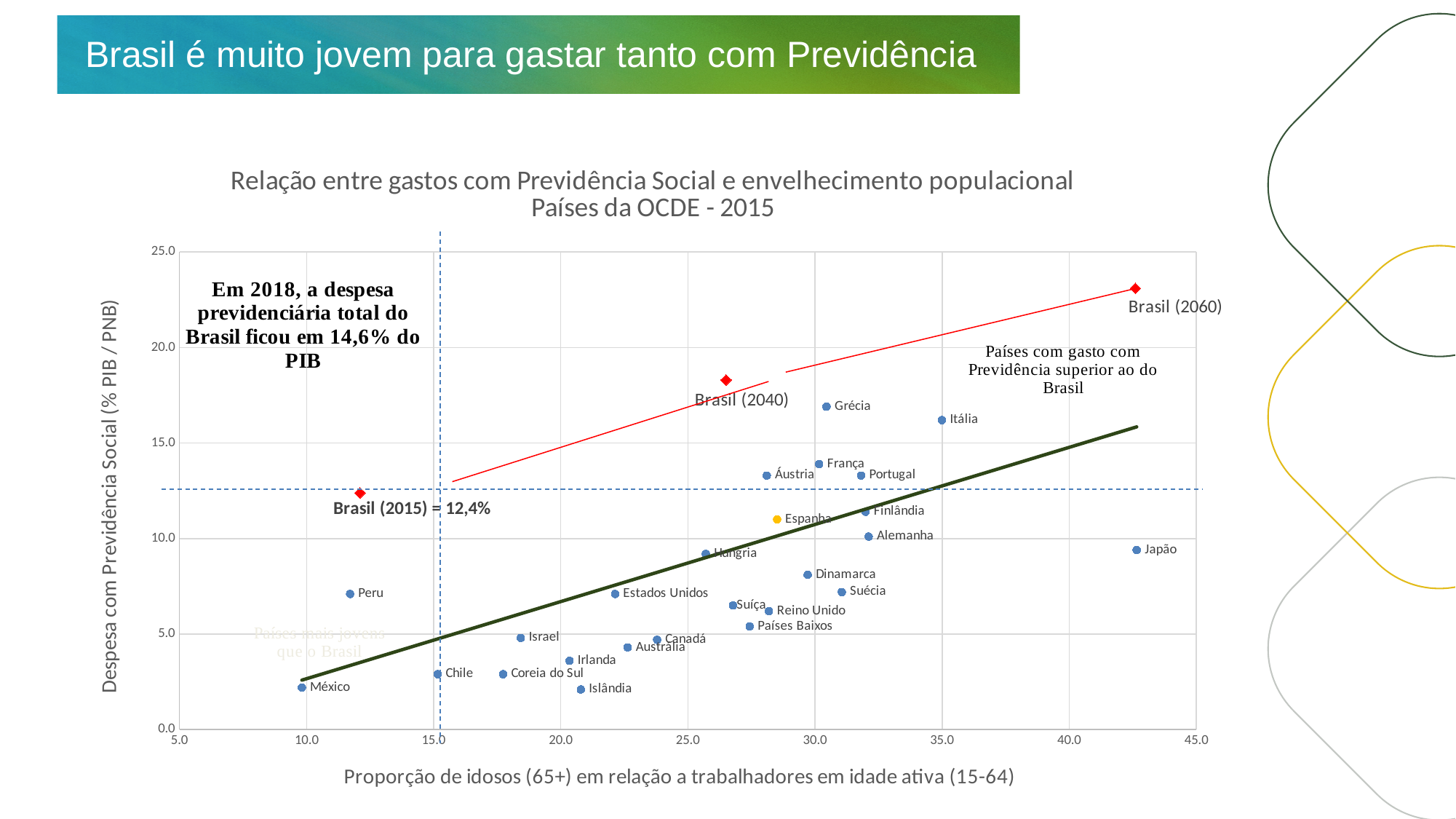
Among the blue OECD country points, which has the highest proportion of elderly (x-axis value)? Japão According to the text box on the chart, what was Brazil's total pension spending as a share of GDP in 2018? 14,6% do PIB Which country has the lowest proportion of elderly (x-axis value) on the chart? México Among the blue OECD country points, which has the highest pension spending (y-axis value)? Grécia Which has higher pension spending, Peru or Chile? Peru Which point has the highest pension spending (y-axis value) on the chart? Brasil (2060) Do pension spending values generally rise or fall as the proportion of elderly increases along the x axis? rise Is the pension spending value for Japão greater or less than 10.0? less Is the pension spending value for Chile greater or less than 5.0? less What kind of chart is shown on the slide? Scatter chart What is the value printed for Brasil (2015)? 12,4% Is the pension spending value for Brasil (2060) greater or less than 20.0? greater